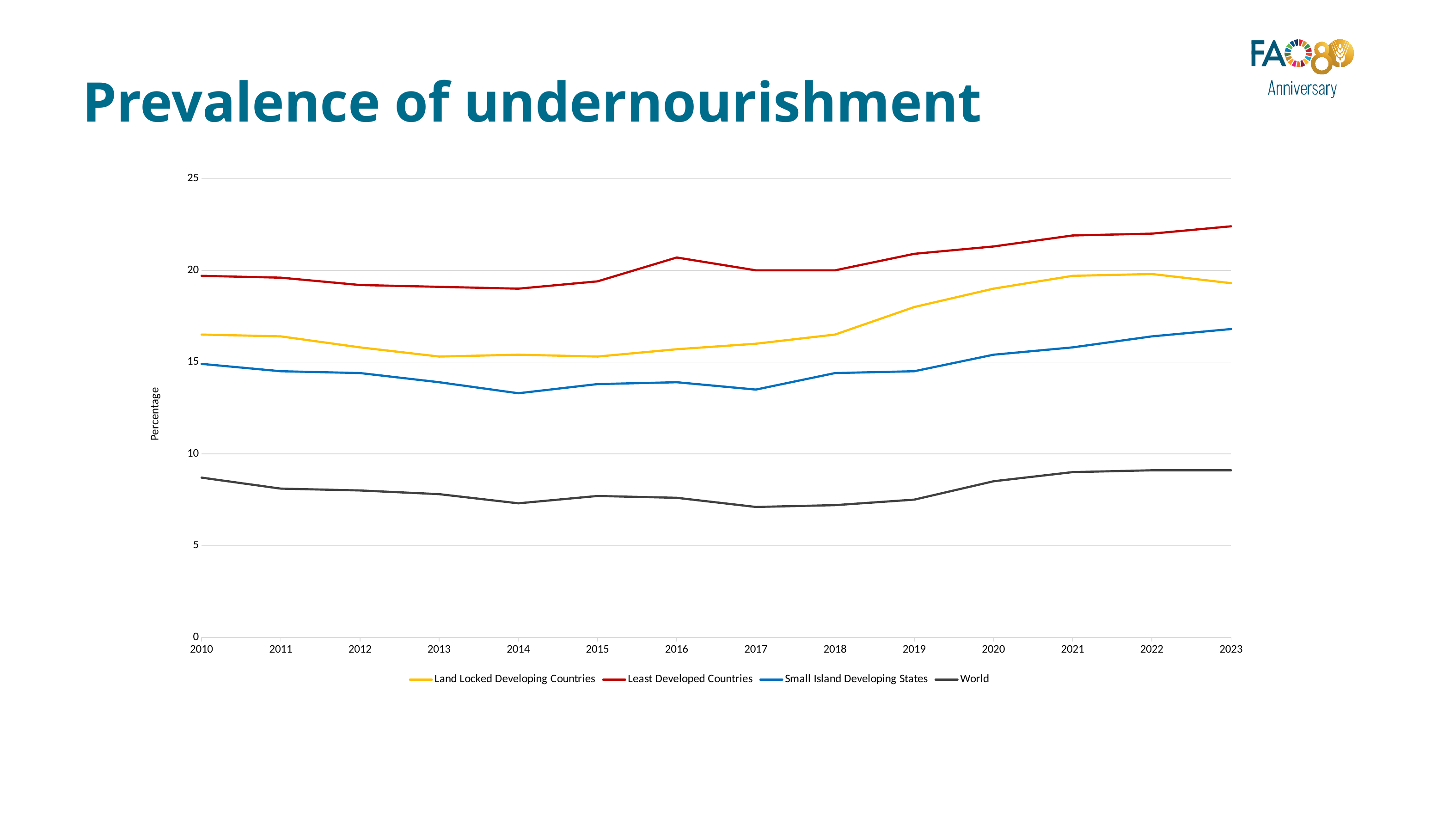
Is the value for Least Developed Countries in 2023 greater or less than 20? greater What is the label on the y axis? Percentage How many series does the legend list? 4 Does the Least Developed Countries line rise or fall from 2018 to 2023? rise In 2010, which is larger: Land Locked Developing Countries or Small Island Developing States? Land Locked Developing Countries Which series has the highest value in 2023? Least Developed Countries Is the value for Land Locked Developing Countries in 2022 greater or less than 15? greater Is the value for World in 2017 greater or less than 10? less Which series has the lowest value in 2010? World How many years are shown along the x axis? 14 What kind of chart is shown on the slide? line chart